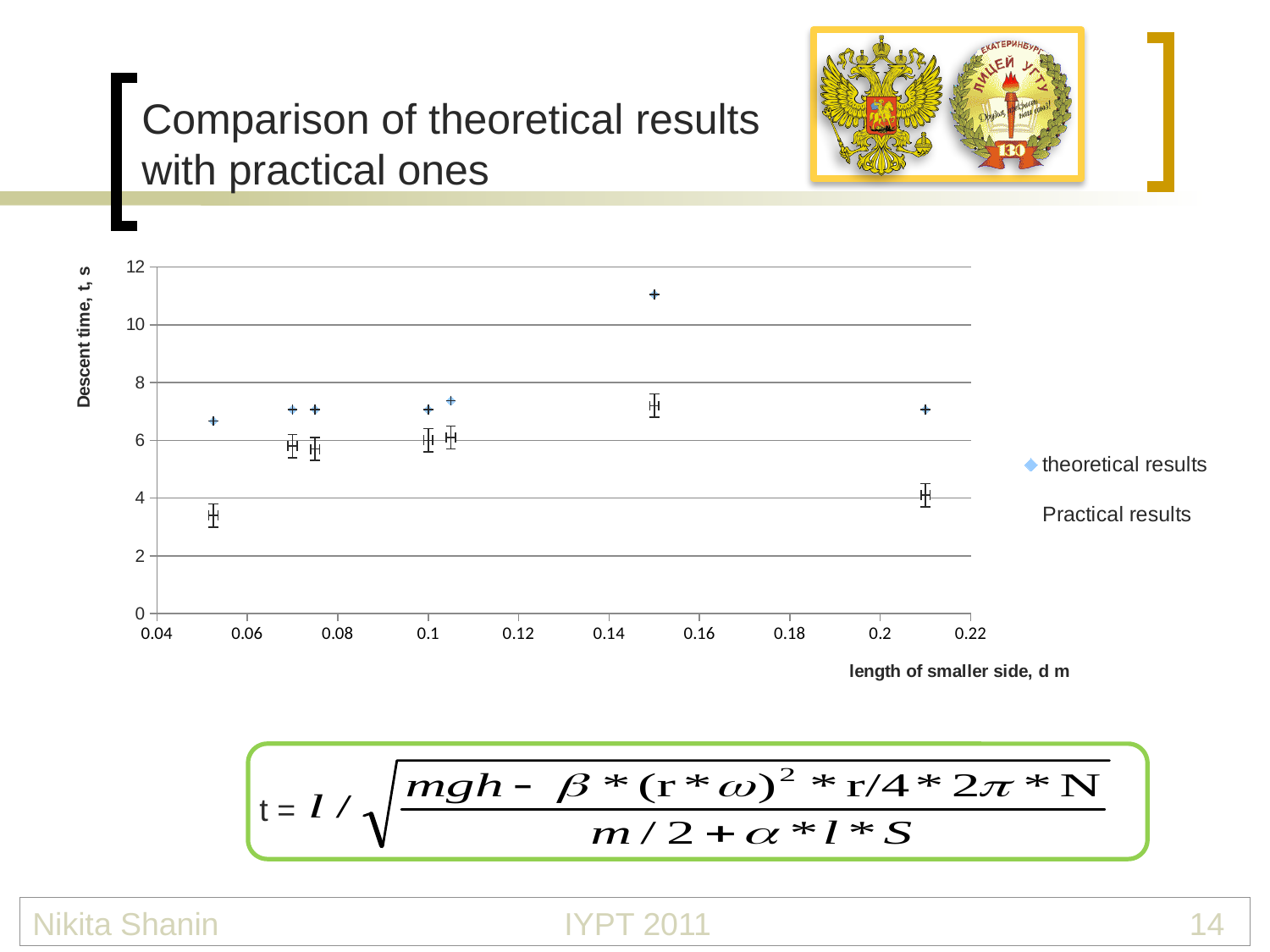
Is the practical result at a side length of about 0.21 m greater or less than 6 s? less What kind of chart is shown on the slide? scatter chart Is the practical result at the smallest plotted side length (about 0.05 m) greater or less than 4 s? less How many series does the chart legend list? 2 At a side length of about 0.15 m, which is larger: the theoretical result or the practical result? theoretical result Is the practical result at a side length of about 0.15 m greater or less than 6 s? greater What is the y-axis title of the chart? Descent time, t, s How many theoretical result points are plotted on the chart? 7 What are the two series named in the chart legend? theoretical results; Practical results